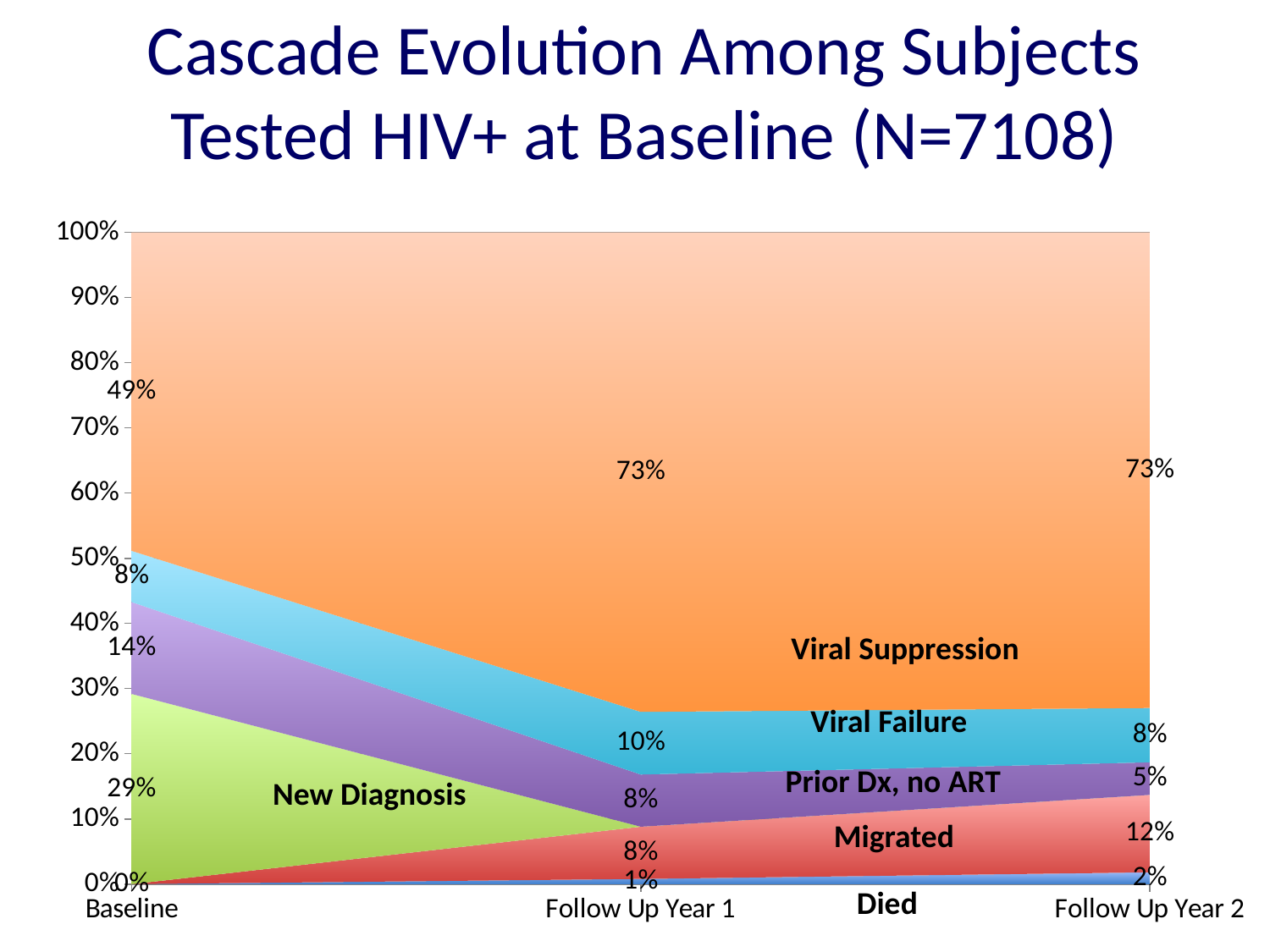
By how many percentage points did Viral Suppression increase from Baseline to Follow Up Year 1? 24 How many time points are shown on the x axis? 3 What is the New Diagnosis value at Baseline? 29% Which is larger at Follow Up Year 2: Migrated or Viral Failure? Migrated What is the Prior Dx, no ART value at Follow Up Year 2? 5% What is the title of the chart? Cascade Evolution Among Subjects Tested HIV+ at Baseline (N=7108) What is the Died value at Follow Up Year 1? 1% What is the Viral Suppression value at Follow Up Year 1? 73% Does the Migrated share rise or fall from Baseline to Follow Up Year 2? Rise What is the Viral Suppression value at Baseline? 49% What type of chart is shown on the slide? Stacked area chart What is the Migrated value at Follow Up Year 2? 12%